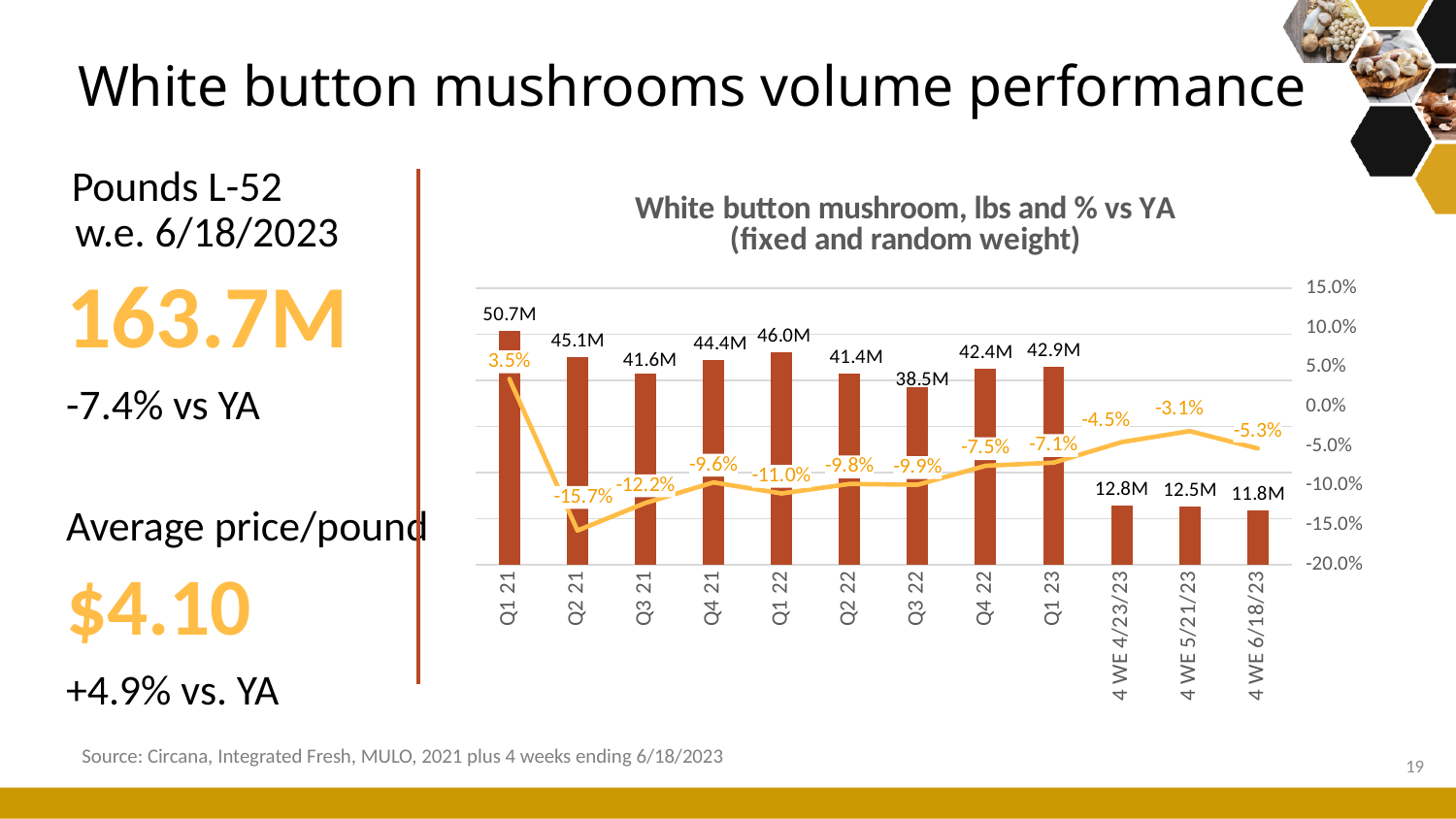
What is the volume in pounds for Q1 21? 50.7M What is the % vs YA value for Q2 21? -15.7% Which period has the lowest % vs YA value? Q2 21 What is the % vs YA value for Q4 22? -7.5% What is the difference in pounds between Q1 22 and Q2 22? 4.6M Which quarter has the highest volume in pounds? Q1 21 Which is larger, the volume for Q4 21 or Q1 22? Q1 22 What is the volume in pounds for the 4 WE 6/18/23 period? 11.8M What is the title of the chart? White button mushroom, lbs and % vs YA (fixed and random weight) What kind of chart is this? Combination bar and line chart How many categories are shown on the x axis? 12 Which period has the highest % vs YA value? Q1 21